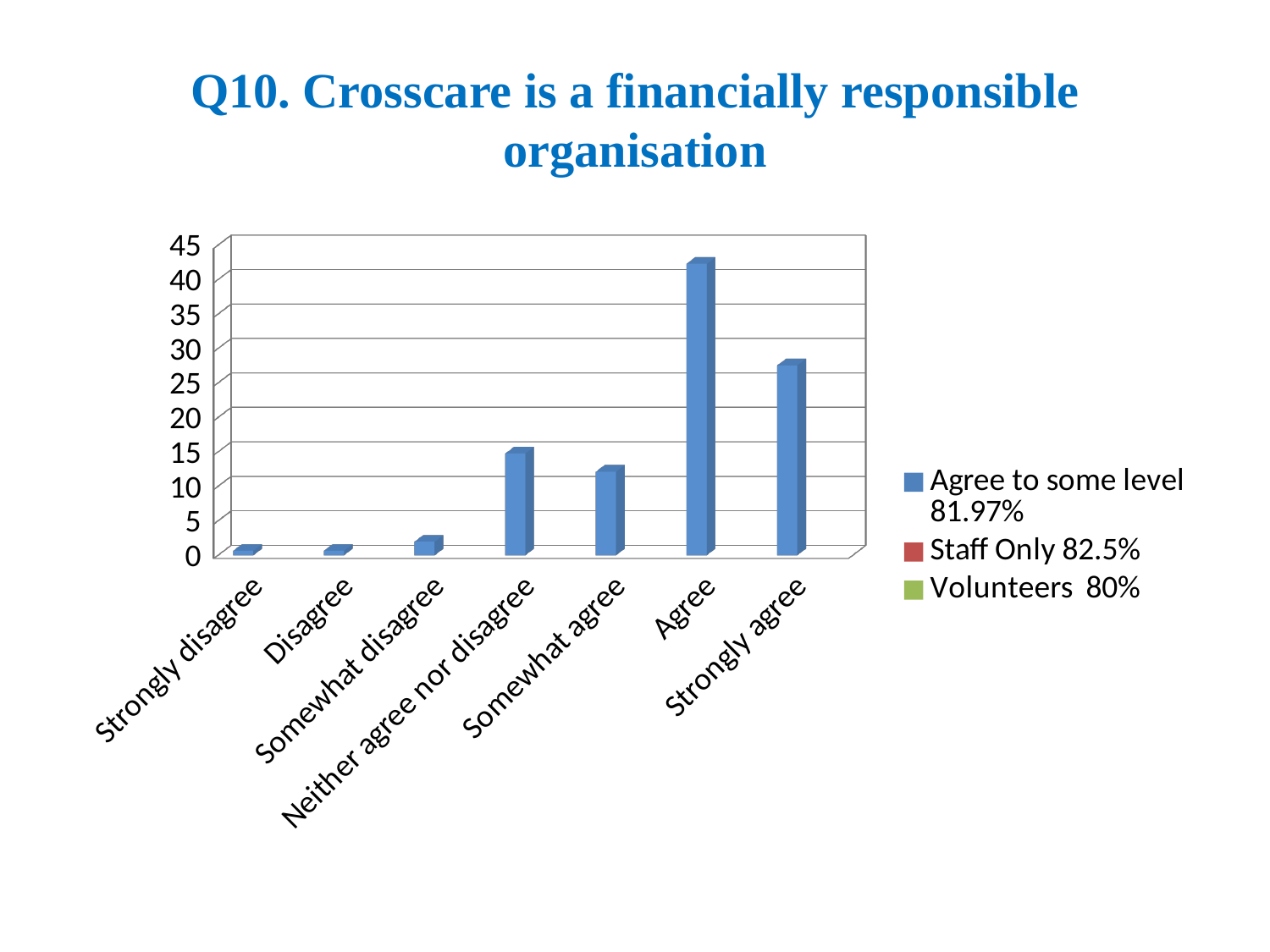
What percentage does the legend give for 'Staff Only'? 82.5% Is the value for Neither agree nor disagree greater or less than 10? greater Is the value for Agree greater or less than 35? greater Which response category has the highest bar? Agree What kind of chart is shown on the slide? bar chart Which is larger, the value for Agree or the value for Strongly agree? Agree How many response categories are shown on the x axis? 7 How many entries does the legend list? 3 What is the title of the chart on the slide? Q10. Crosscare is a financially responsible organisation Is the value for Strongly agree greater or less than 20? greater Which is larger, the value for Strongly agree or the value for Somewhat agree? Strongly agree